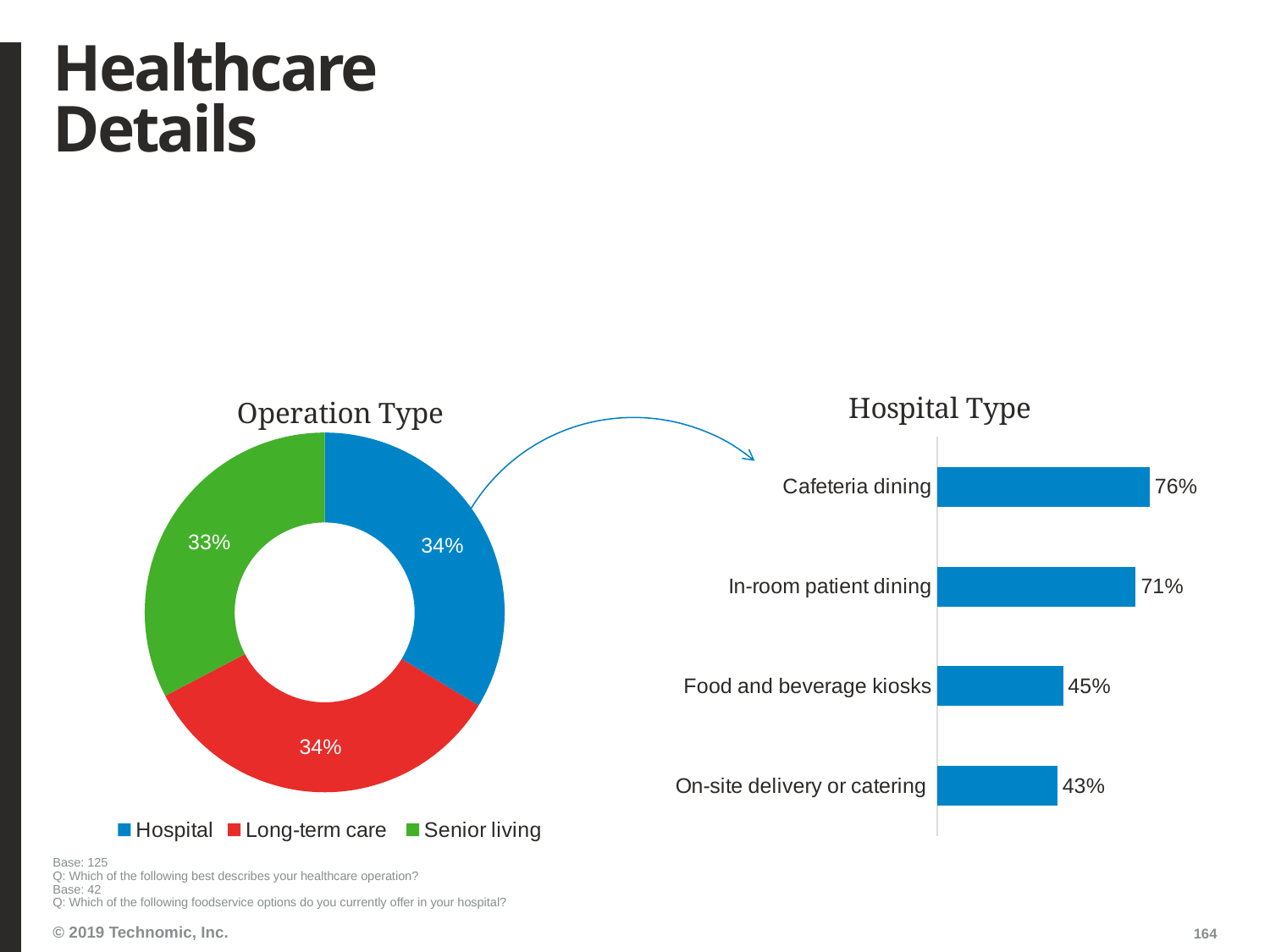
In the Operation Type chart, what share is Senior living? 33% In the Hospital Type chart, what is the difference between Cafeteria dining and Food and beverage kiosks? 31% What kind of chart is the Hospital Type chart? Bar chart In the Hospital Type chart, which category has the lowest value? On-site delivery or catering In the Operation Type chart, which colour represents Long-term care? Red In the Hospital Type chart, what is the value for On-site delivery or catering? 43% What kind of chart is the Operation Type chart? Doughnut chart In the Hospital Type chart, which category has the highest value? Cafeteria dining In the Operation Type chart, what share is Long-term care? 34% In the Operation Type chart, what share is Hospital? 34% In the Hospital Type chart, what is the value for Cafeteria dining? 76% In the Operation Type chart, how many categories does the legend list? 3